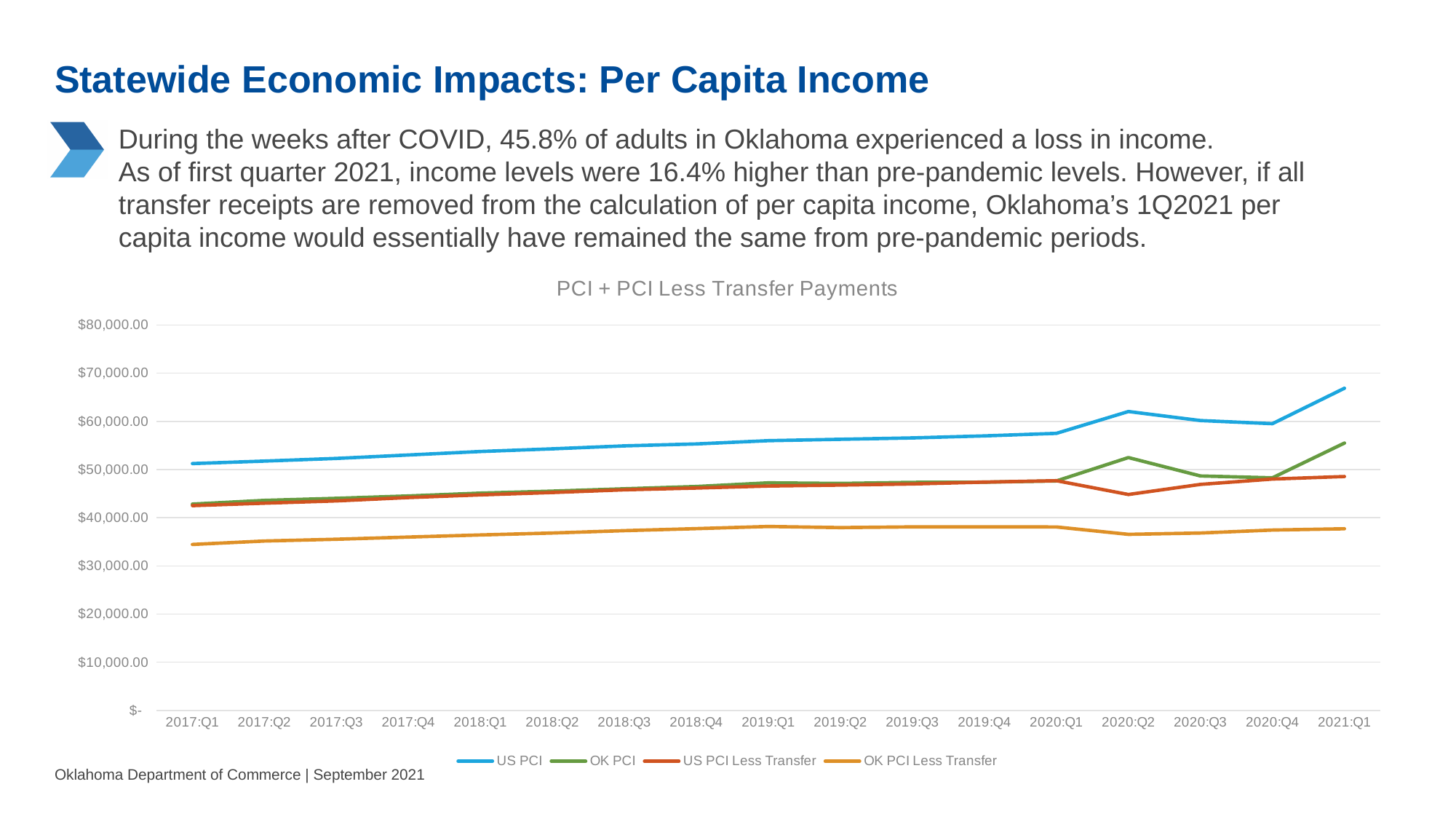
Is the value for US PCI at 2021:Q1 greater or less than $60,000.00? greater Which series has the highest value at 2021:Q1? US PCI What colour is the US PCI line in the chart? blue At 2021:Q1, which is larger: US PCI or OK PCI? US PCI Is the value for OK PCI Less Transfer at 2017:Q1 greater or less than $40,000.00? less How many series does the chart's legend list? 4 How many quarters are plotted along the x axis of the chart? 17 What kind of chart is shown on the slide? line chart What is the title of the chart? PCI + PCI Less Transfer Payments Which series has the lowest value at 2020:Q2? OK PCI Less Transfer Is the value for OK PCI at 2020:Q2 greater or less than $50,000.00? greater Does the US PCI line rise or fall from 2017:Q1 to 2021:Q1? rise